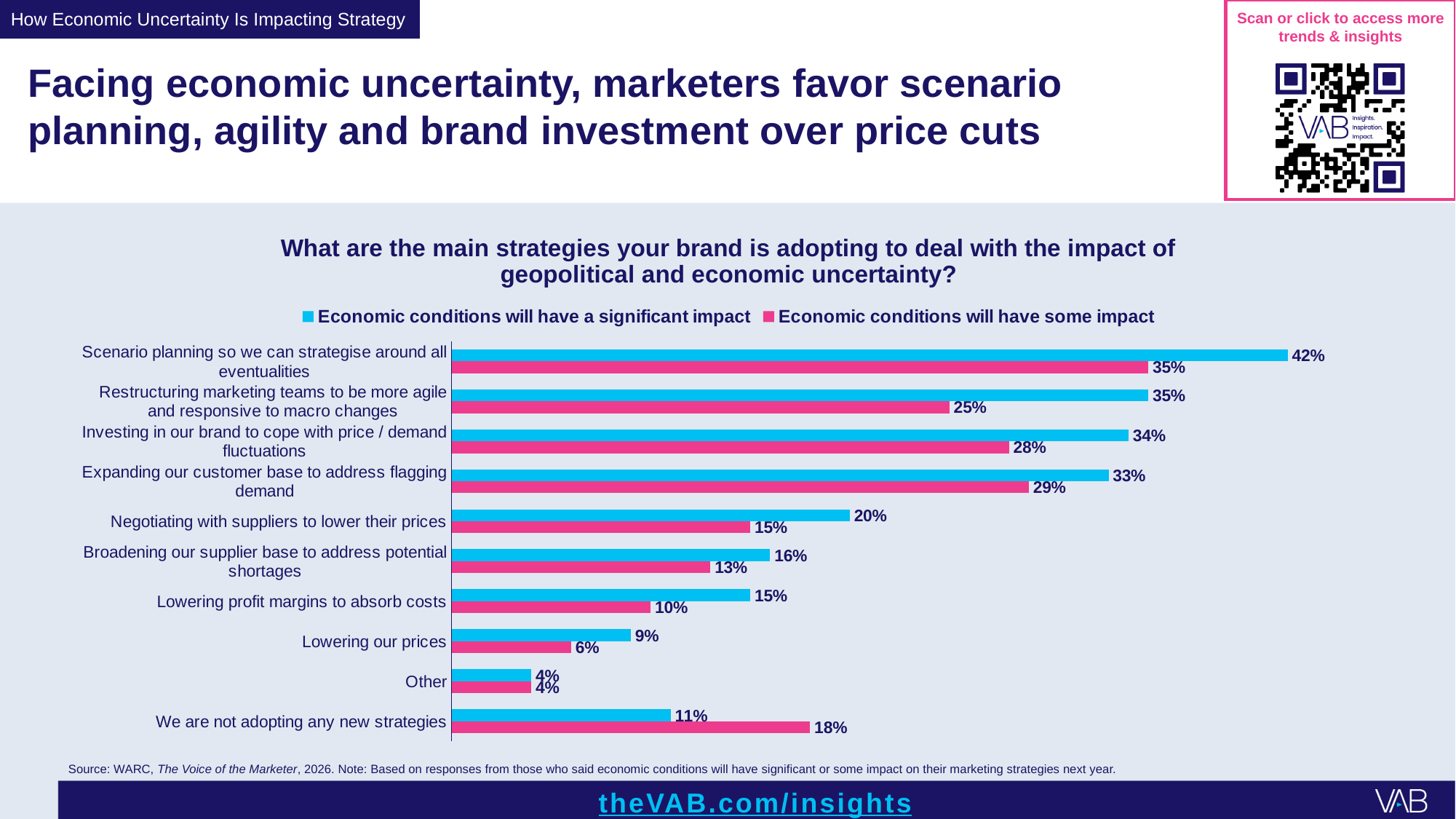
Which category has the lowest value in the 'Economic conditions will have some impact' series? Other What is the difference between the two series for 'Restructuring marketing teams to be more agile and responsive to macro changes'? 10 percentage points How many strategy categories are shown on the chart? 10 What percentage of respondents who said economic conditions will have a significant impact chose scenario planning so we can strategise around all eventualities? 42% Which colour represents the 'Economic conditions will have some impact' series? Pink What kind of chart is shown on the slide? Bar chart Which strategy has the highest value in the 'Economic conditions will have a significant impact' series? Scenario planning so we can strategise around all eventualities For 'We are not adopting any new strategies', which series has the larger value? Economic conditions will have some impact What is the value for 'Negotiating with suppliers to lower their prices' in the 'Economic conditions will have a significant impact' series? 20% How many series does the legend list? 2 What is the difference between the 'significant impact' and 'some impact' values for 'Lowering profit margins to absorb costs'? 5 percentage points What is the value for 'Lowering our prices' in the 'Economic conditions will have some impact' series? 6%